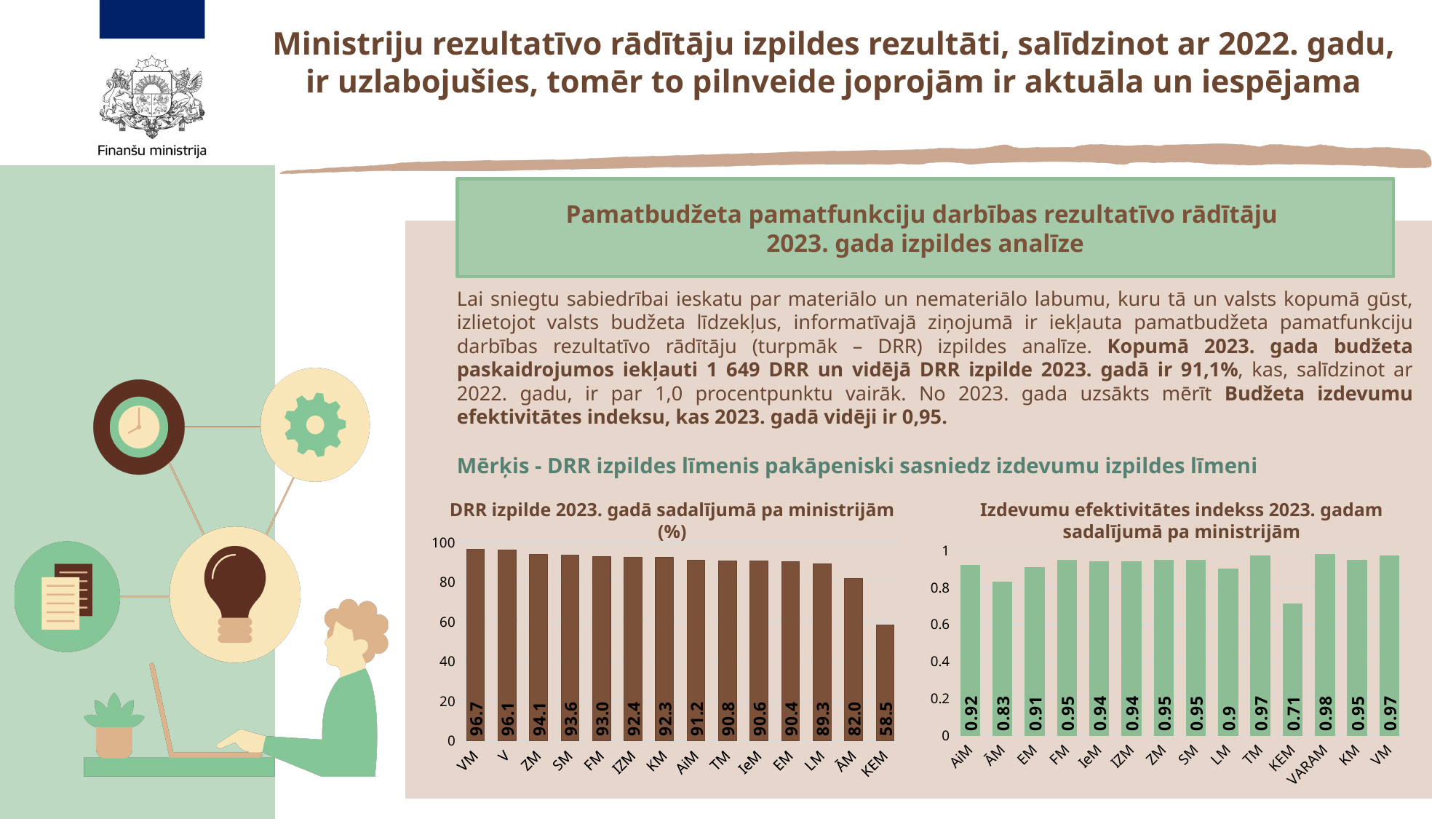
In the chart 'Izdevumu efektivitātes indekss 2023. gadam sadalījumā pa ministrijām', which ministry has the lowest value? KEM In the chart 'Izdevumu efektivitātes indekss 2023. gadam sadalījumā pa ministrijām', what is the value for LM? 0.9 What kind of chart is 'Izdevumu efektivitātes indekss 2023. gadam sadalījumā pa ministrijām'? Bar chart In the chart 'DRR izpilde 2023. gadā sadalījumā pa ministrijām (%)', which ministry has the lowest value? KEM In the chart 'Izdevumu efektivitātes indekss 2023. gadam sadalījumā pa ministrijām', what is the value for VARAM? 0.98 In the chart 'Izdevumu efektivitātes indekss 2023. gadam sadalījumā pa ministrijām', which ministry has the highest value? VARAM In the chart 'DRR izpilde 2023. gadā sadalījumā pa ministrijām (%)', what is the value for VM? 96.7 In the chart 'DRR izpilde 2023. gadā sadalījumā pa ministrijām (%)', which ministry has the highest value? VM In the chart 'DRR izpilde 2023. gadā sadalījumā pa ministrijām (%)', what is the difference between the values for ĀM and KEM? 23.5 In the chart 'DRR izpilde 2023. gadā sadalījumā pa ministrijām (%)', which is larger, the value for ZM or the value for LM? ZM In the chart 'Izdevumu efektivitātes indekss 2023. gadam sadalījumā pa ministrijām', what is the difference between the values for TM and ĀM? 0.14 In the chart 'DRR izpilde 2023. gadā sadalījumā pa ministrijām (%)', how many ministries are shown? 14